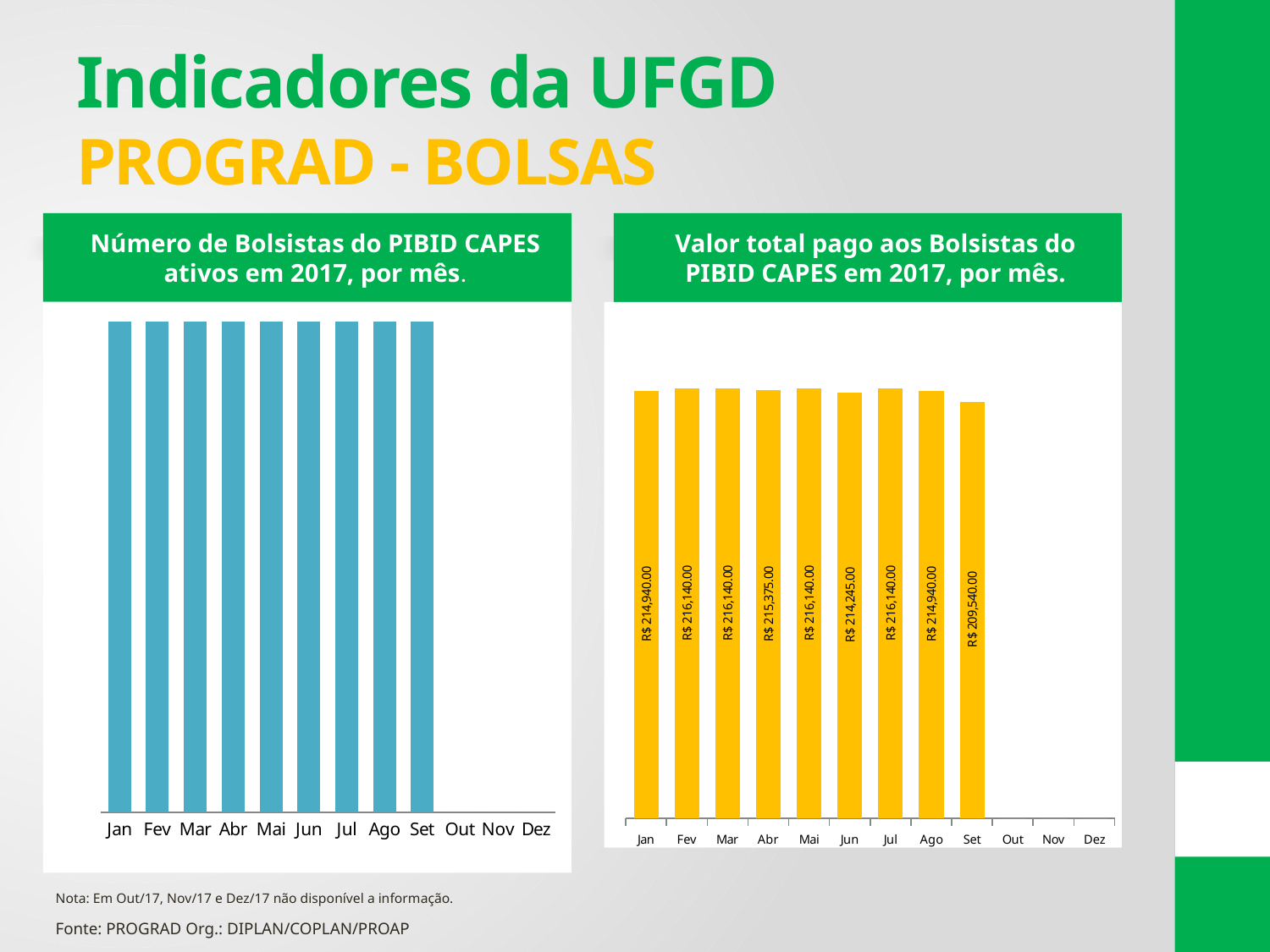
In the chart 'Valor total pago aos Bolsistas do PIBID CAPES em 2017, por mês', what is the value for Jan? R$ 214,940.00 In the chart 'Valor total pago aos Bolsistas do PIBID CAPES em 2017, por mês', what is the difference between the values for Fev and Set? R$ 6,600.00 In the chart 'Valor total pago aos Bolsistas do PIBID CAPES em 2017, por mês', what is the value for Set? R$ 209,540.00 In the chart 'Valor total pago aos Bolsistas do PIBID CAPES em 2017, por mês', what is the difference between the values for Jan and Jun? R$ 695.00 What is the title of the chart on the right of the slide? Valor total pago aos Bolsistas do PIBID CAPES em 2017, por mês. In the chart 'Valor total pago aos Bolsistas do PIBID CAPES em 2017, por mês', how many months have a bar plotted? 9 In the chart 'Valor total pago aos Bolsistas do PIBID CAPES em 2017, por mês', which month has the lowest value? Set What kind of chart is the chart on the left, 'Número de Bolsistas do PIBID CAPES ativos em 2017, por mês'? Bar chart In the chart on the left, 'Número de Bolsistas do PIBID CAPES ativos em 2017, por mês', how many months have a bar plotted? 9 In the chart 'Valor total pago aos Bolsistas do PIBID CAPES em 2017, por mês', what is the value for Jun? R$ 214,245.00 In the chart 'Valor total pago aos Bolsistas do PIBID CAPES em 2017, por mês', which is larger, the value for Mar or the value for Ago? Mar In the chart 'Valor total pago aos Bolsistas do PIBID CAPES em 2017, por mês', what is the value for Abr? R$ 215,375.00